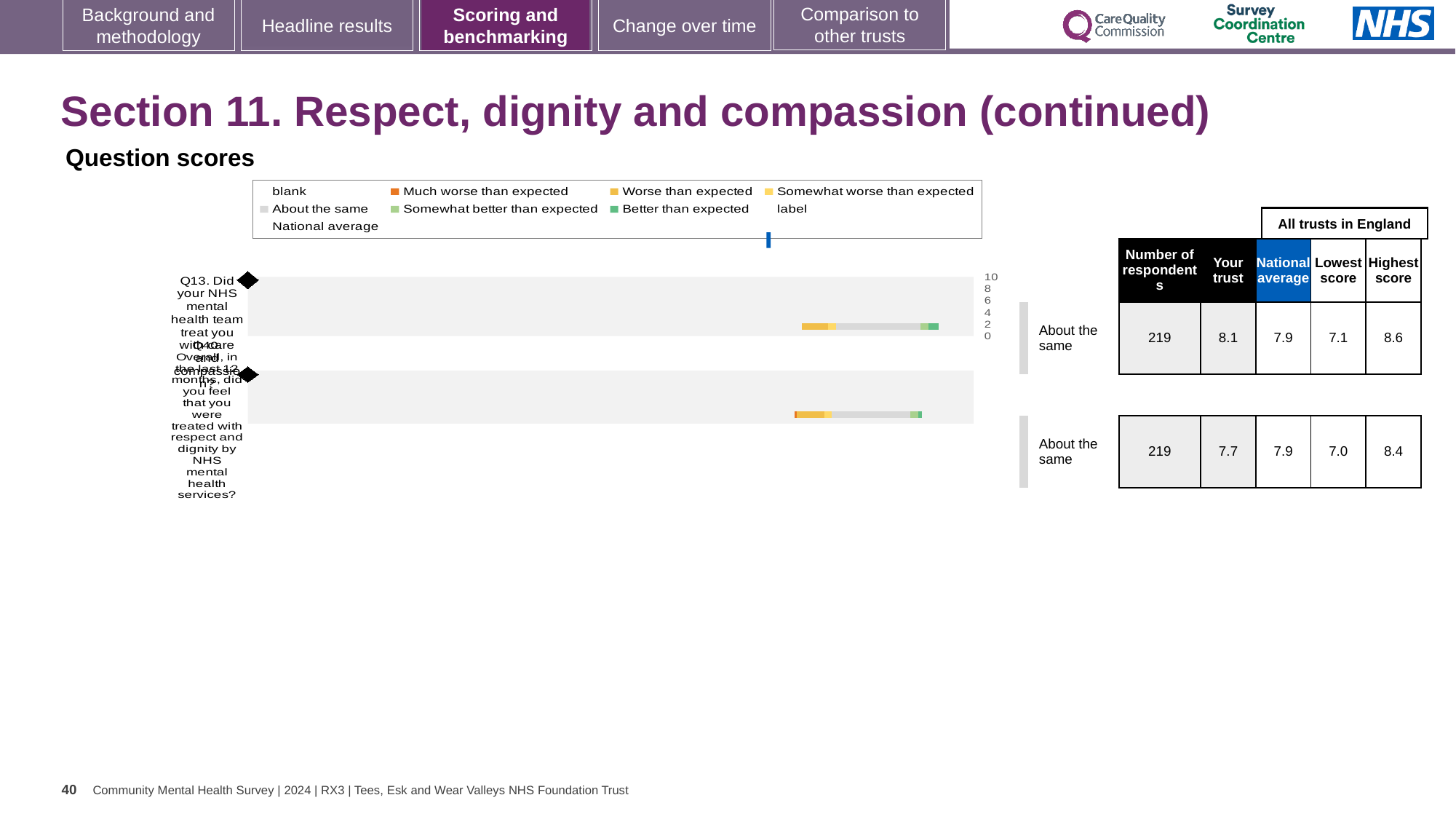
How many questions are plotted in the chart? 2 What is the difference between the highest and lowest scores for Q14? 1.4 How many respondents answered Q14? 219 What is the national average score shown for Q13? 7.9 What is the lowest score among all trusts in England for Q13? 7.1 What is the highest score among all trusts in England for Q14? 8.4 Which question has the higher 'Your trust' score, Q13 or Q14? Q13 What is the 'Your trust' score for Q13 (Did your NHS mental health team treat you with care and compassion?)? 8.1 By how much does the trust's score for Q13 exceed the national average? 0.2 What benchmark category is shown for Q13? About the same What is the 'Your trust' score for Q14 (treated with respect and dignity by NHS mental health services)? 7.7 What kind of chart is used to show the question scores? Bar chart